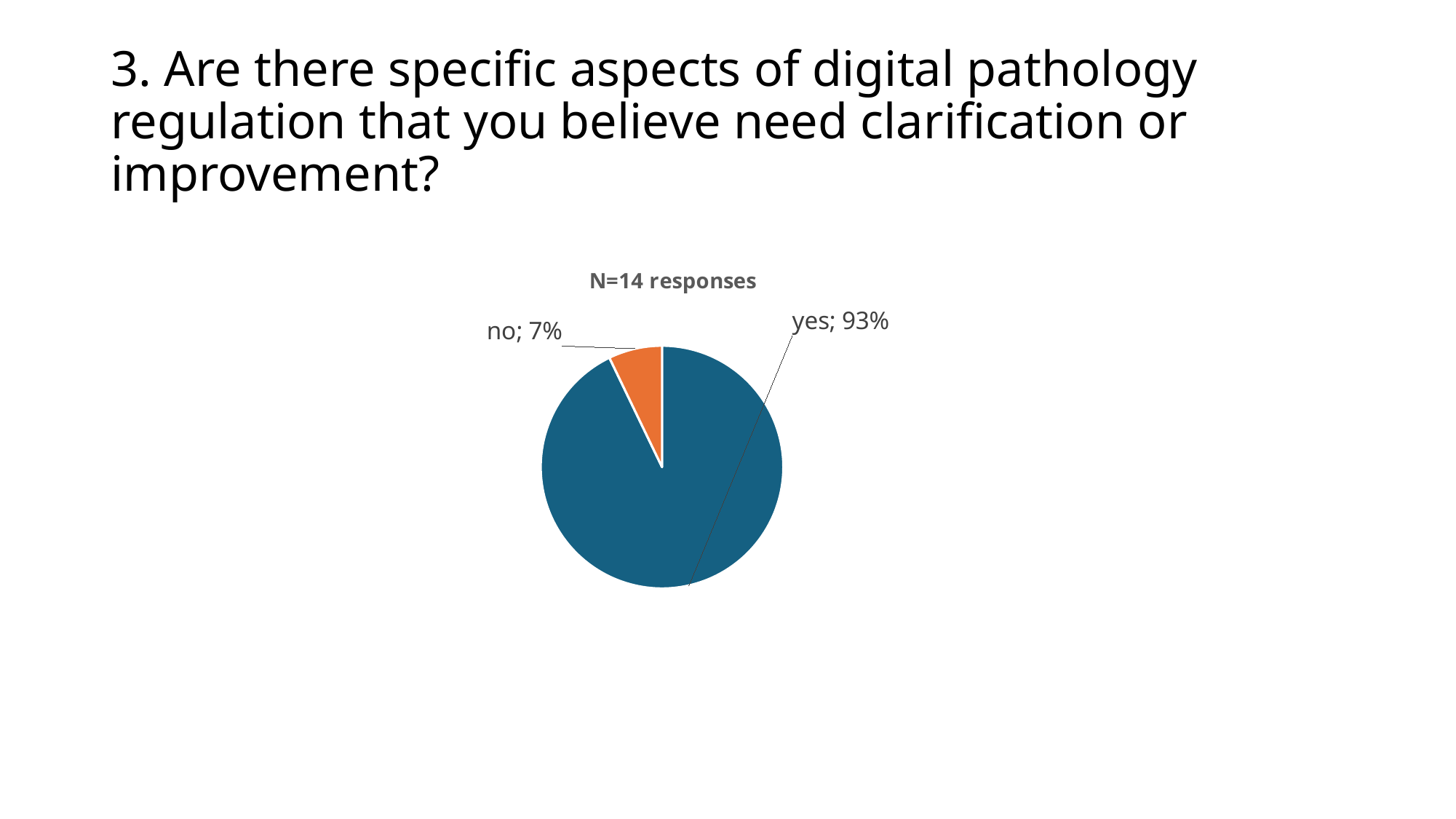
What colour is the "no" slice? orange What share of responses is labelled "no"? 7% What kind of chart is shown on the slide? pie chart Which is larger, the "yes" slice or the "no" slice? yes How many slices does the pie chart have? 2 What is the difference in percentage points between the "yes" and "no" slices? 86 What is the title of the pie chart? N=14 responses What share of responses is labelled "yes"? 93% How many responses does the chart title say were collected? 14 Which slice of the pie is the largest? yes Which slice of the pie is the smallest? no